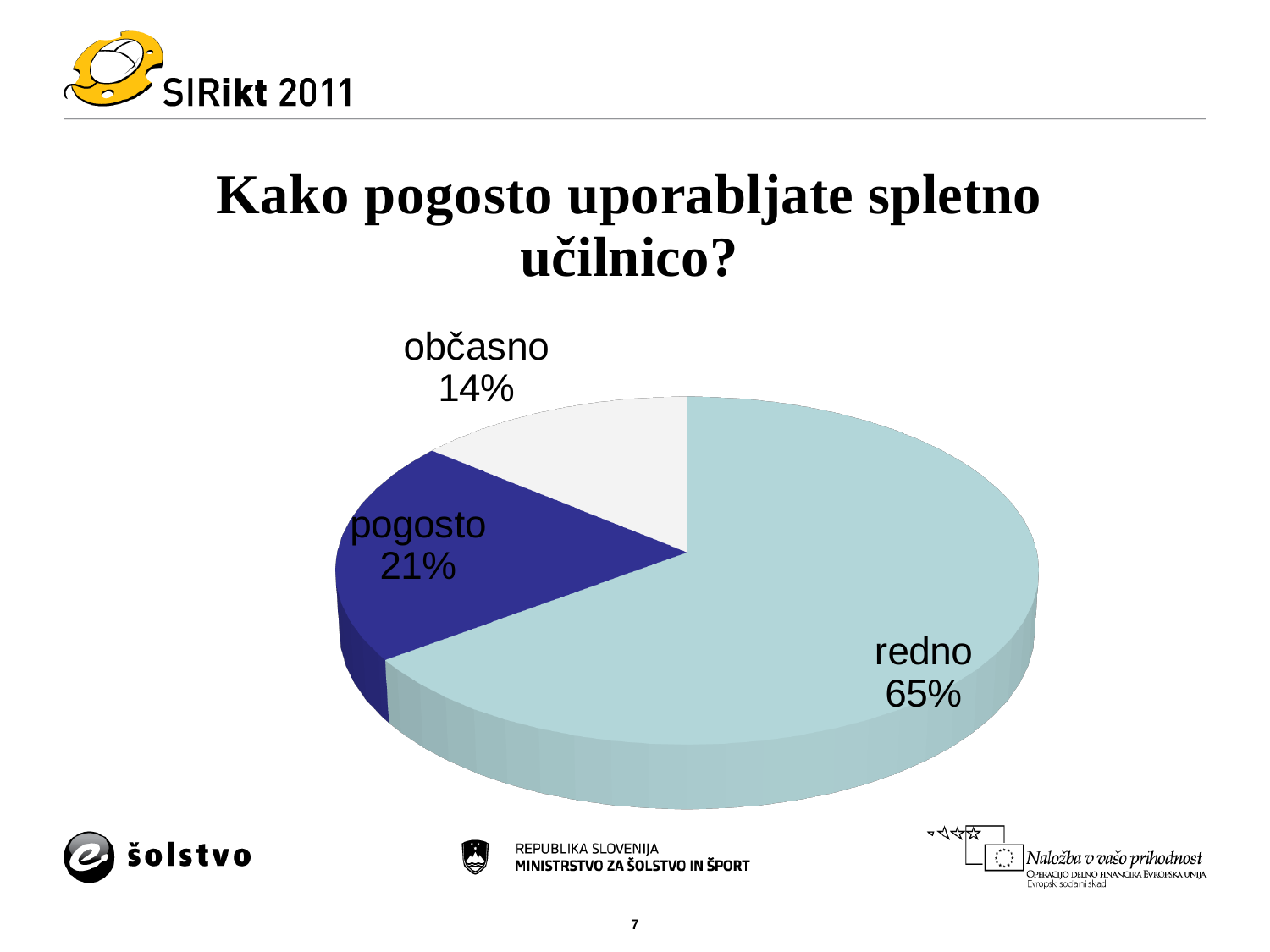
What percentage is shown for the 'pogosto' slice? 21% What percentage is shown for the 'občasno' slice? 14% What kind of chart is shown on the slide? pie chart What is the difference in percentage points between 'pogosto' and 'občasno'? 7 What is the title of the chart on the slide? Kako pogosto uporabljate spletno učilnico? Which category has the largest share of the pie? redno What colour is the 'pogosto' slice? dark blue How many slices does the pie chart have? 3 Which category has the smallest share of the pie? občasno What is the difference in percentage points between 'redno' and 'pogosto'? 44 What percentage of respondents use the online classroom 'redno'? 65% Which slice is larger, 'pogosto' or 'občasno'? pogosto